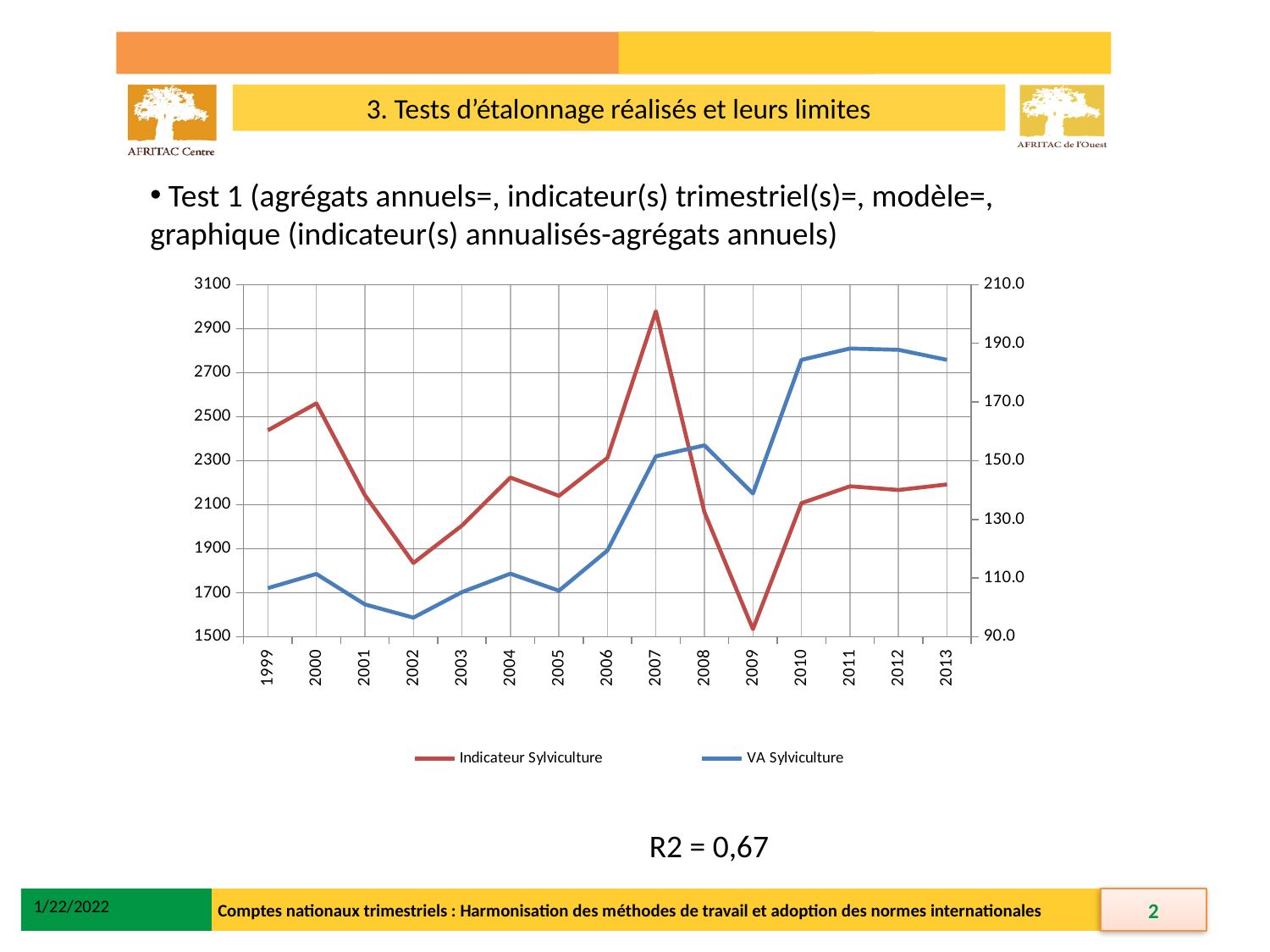
Is the value for Indicateur Sylviculture in 2007 greater or less than 2900? greater In which year does the VA Sylviculture series reach its lowest value? 2002 Does the VA Sylviculture series rise or fall between 2009 and 2011? rise Which colour is used for the VA Sylviculture line? blue Is the value for VA Sylviculture in 2010 greater or less than 170.0? greater How many series does the legend list? 2 Which is larger for Indicateur Sylviculture: the value in 2000 or the value in 2004? 2000 In which year does the Indicateur Sylviculture series reach its highest value? 2007 How many years are plotted along the x axis? 15 In which year does the Indicateur Sylviculture series reach its lowest value? 2009 What kind of chart is shown on the slide? line chart Is the value for Indicateur Sylviculture in 2009 greater or less than 1700? less